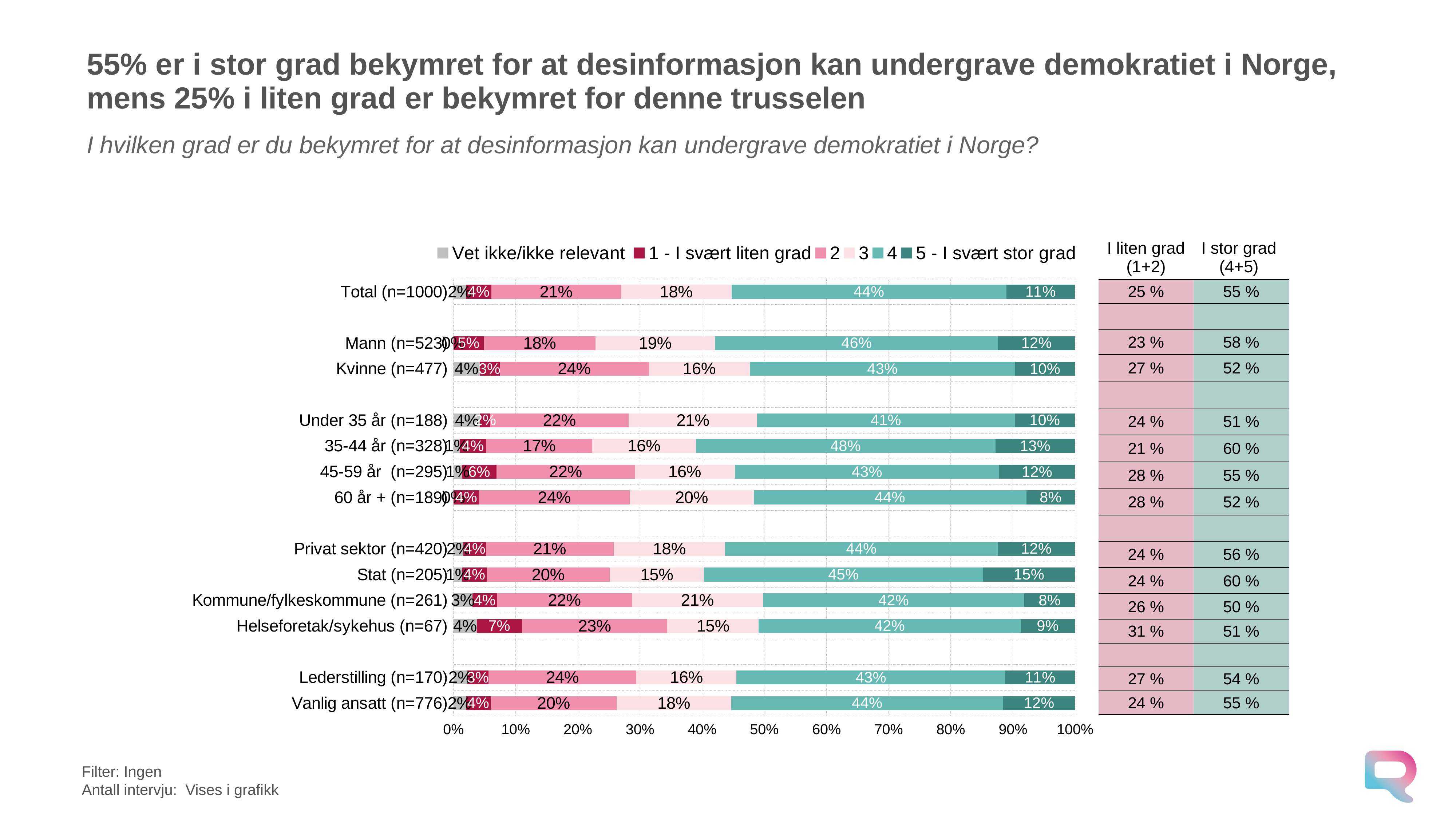
Which category has the highest value for the '1 - I svært liten grad' series? Helseforetak/sykehus (n=67) Which has the larger '4' value, Mann (n=523) or Kvinne (n=477)? Mann (n=523) What is the value of the '5 - I svært stor grad' series for Stat (n=205)? 15% How many series does the legend list? 6 What is the value of the '2' series for Helseforetak/sykehus (n=67)? 23% What is the value of the '3' series for Kvinne (n=477)? 16% What kind of chart is shown on the slide? bar chart Which category has the highest value for the '4' series? 35-44 år (n=328) What is the value of the '4' series for Mann (n=523)? 46% What is the difference between the '5 - I svært stor grad' values for Stat (n=205) and Kommune/fylkeskommune (n=261)? 7 percentage points Which category has the highest value for the '5 - I svært stor grad' series? Stat (n=205) How many categories (bars) are plotted in the chart? 13